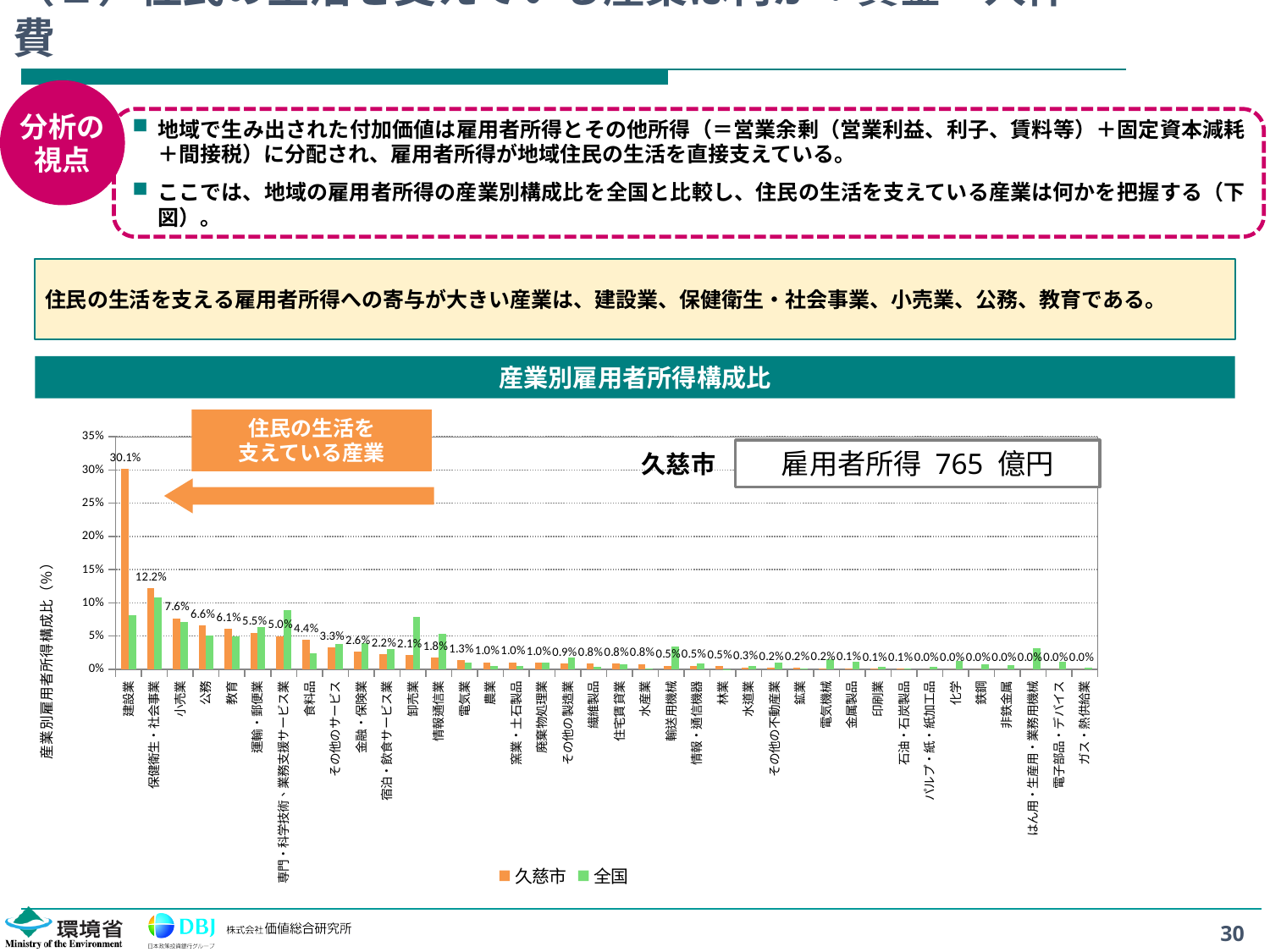
What type of chart is shown on the slide? bar chart What is the 久慈市 value for 小売業? 7.6% What is the difference between the 久慈市 values for 建設業 and 保健衛生・社会事業? 17.9% For 建設業, which series has the larger value, 久慈市 or 全国? 久慈市 What is the 久慈市 value for 建設業? 30.1% What is the title of the chart? 産業別雇用者所得構成比 Is the 全国 value for 専門・科学技術、業務支援サービス業 greater or less than 5%? greater How many series does the legend list? 2 Is the 全国 value for 建設業 greater or less than 10%? less What is the 久慈市 value for 保健衛生・社会事業? 12.2% Which industry has the highest 久慈市 value? 建設業 For 卸売業, which series has the larger value, 久慈市 or 全国? 全国